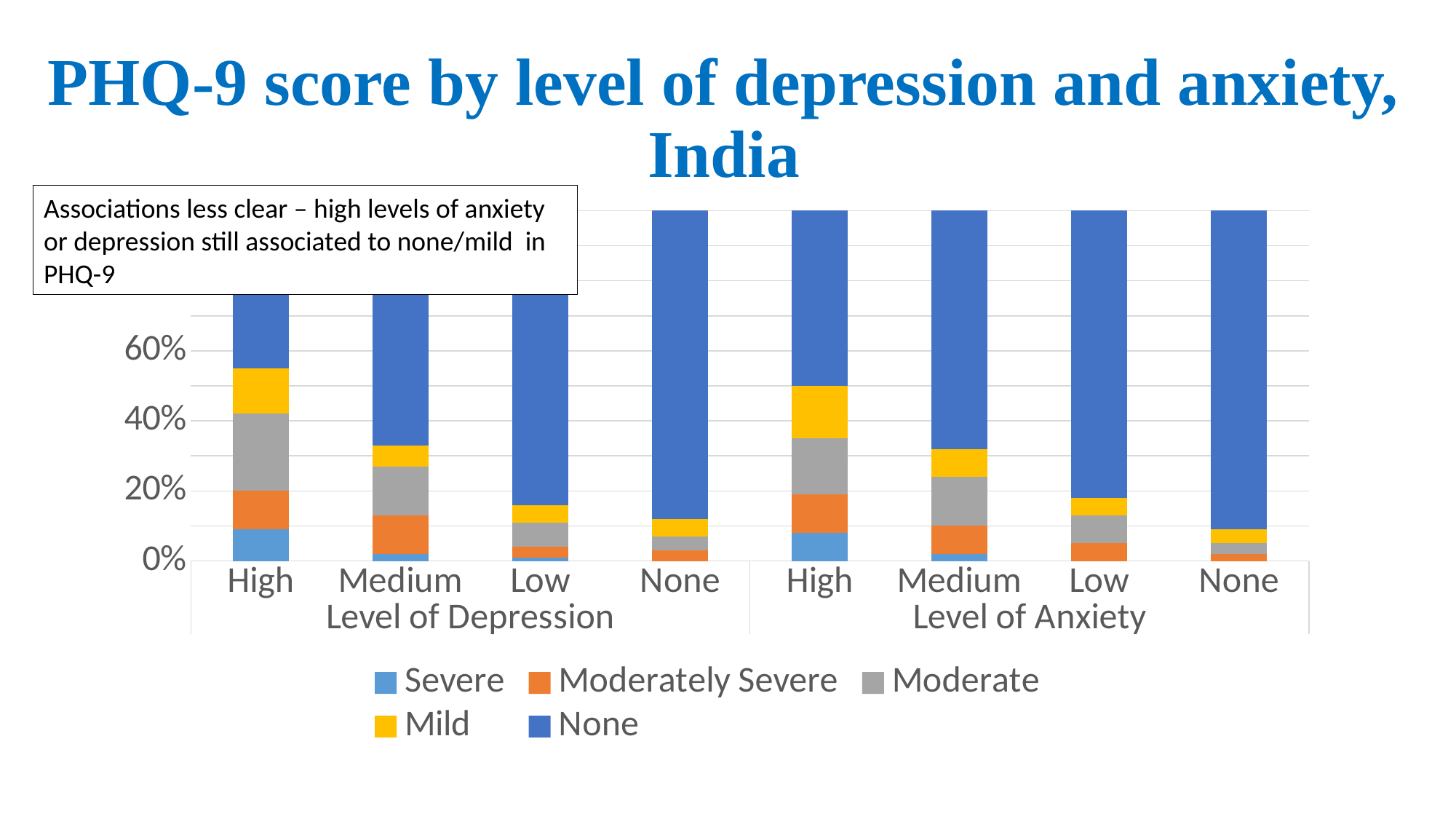
Moving from High to None along the Level of Depression categories, does the None (PHQ-9) share rise or fall? rise How many series does the legend list? 5 Which series are listed in the legend? Severe, Moderately Severe, Moderate, Mild, None What kind of chart is shown on the slide? Stacked bar chart Is the Severe share for High level of depression greater or less than 20%? less Is the Severe segment larger for High level of depression or Medium level of depression? High Is the Moderately Severe segment larger for Medium level of depression or Low level of depression? Medium Is the None (PHQ-9) segment larger for High level of depression or High level of anxiety? High level of anxiety Is the None (PHQ-9) share for the None level of depression greater or less than 60%? greater How many bars are plotted in the chart? 8 Is the combined share of Severe through Mild for High level of anxiety greater or less than 60%? less What are the two groups of categories on the x axis? Level of Depression and Level of Anxiety